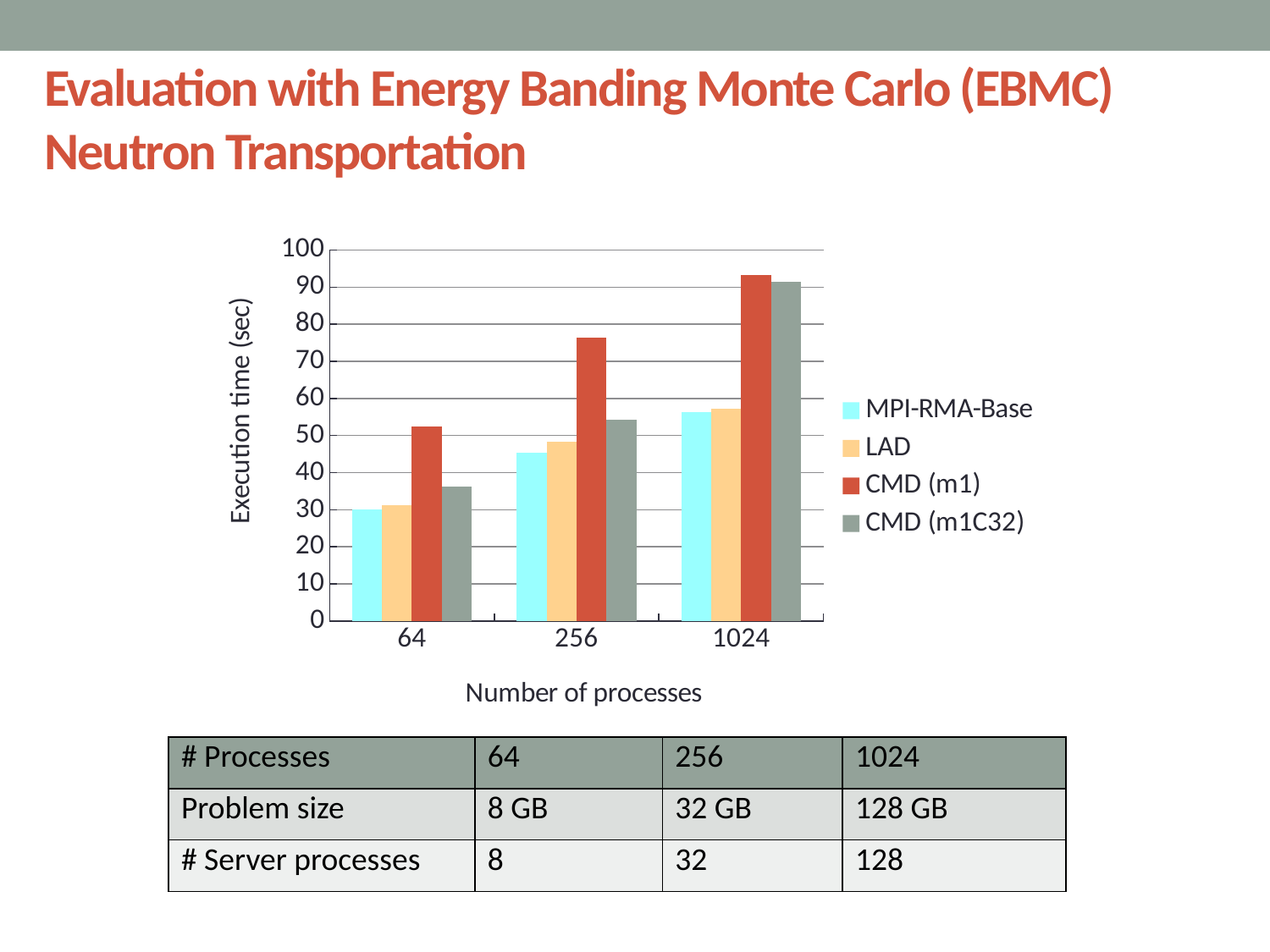
Does the execution time for LAD rise or fall as the number of processes increases from 64 to 1024? rises How many process-count categories are shown on the x axis? 3 How many series does the chart legend list? 4 What kind of chart is shown on the slide? bar chart What is the label of the y axis? Execution time (sec) Is the execution time for CMD (m1) at 1024 processes greater or less than 90? greater Which series has the lowest execution time at 256 processes? MPI-RMA-Base Is the execution time for CMD (m1C32) at 256 processes greater or less than 50? greater Which is larger at 64 processes: the execution time for CMD (m1) or for CMD (m1C32)? CMD (m1) Which series has the highest execution time at 64 processes? CMD (m1) Which series has the highest execution time at 256 processes? CMD (m1) Is the execution time for MPI-RMA-Base at 64 processes greater or less than 40? less